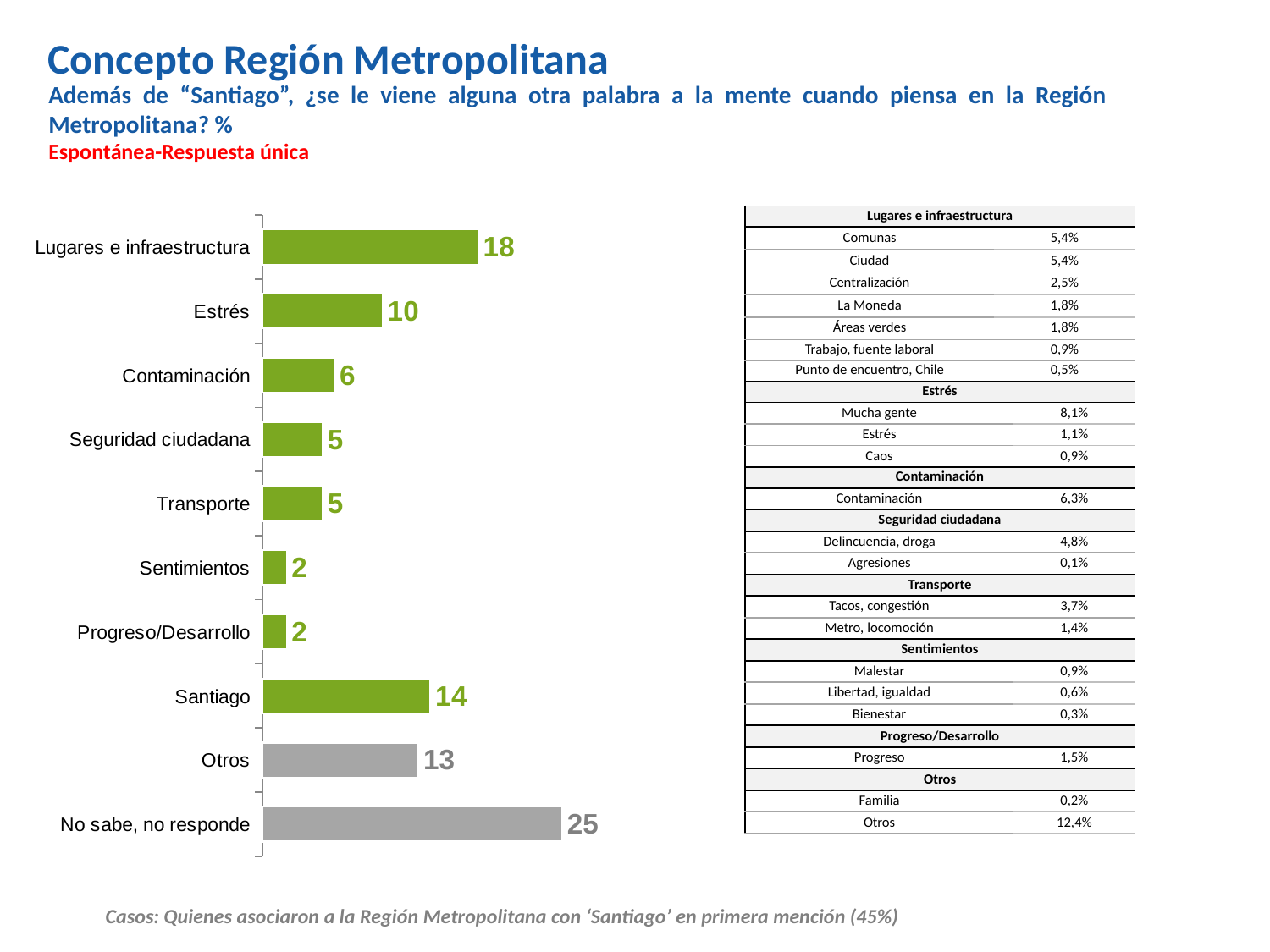
What is the difference between the values for Lugares e infraestructura and Estrés? 8 What is the value for Estrés? 10 Which is larger, the value for Contaminación or the value for Transporte? Contaminación What kind of chart is shown on the slide? Bar chart What is the value for Otros? 13 Which category has the highest value among the green bars? Lugares e infraestructura What is the difference between the values for No sabe, no responde and Santiago? 11 What is the value for Santiago? 14 How many categories are shown in the chart? 10 Which category has the highest value? No sabe, no responde What is the value for Lugares e infraestructura? 18 Which is larger, the value for Santiago or the value for Otros? Santiago